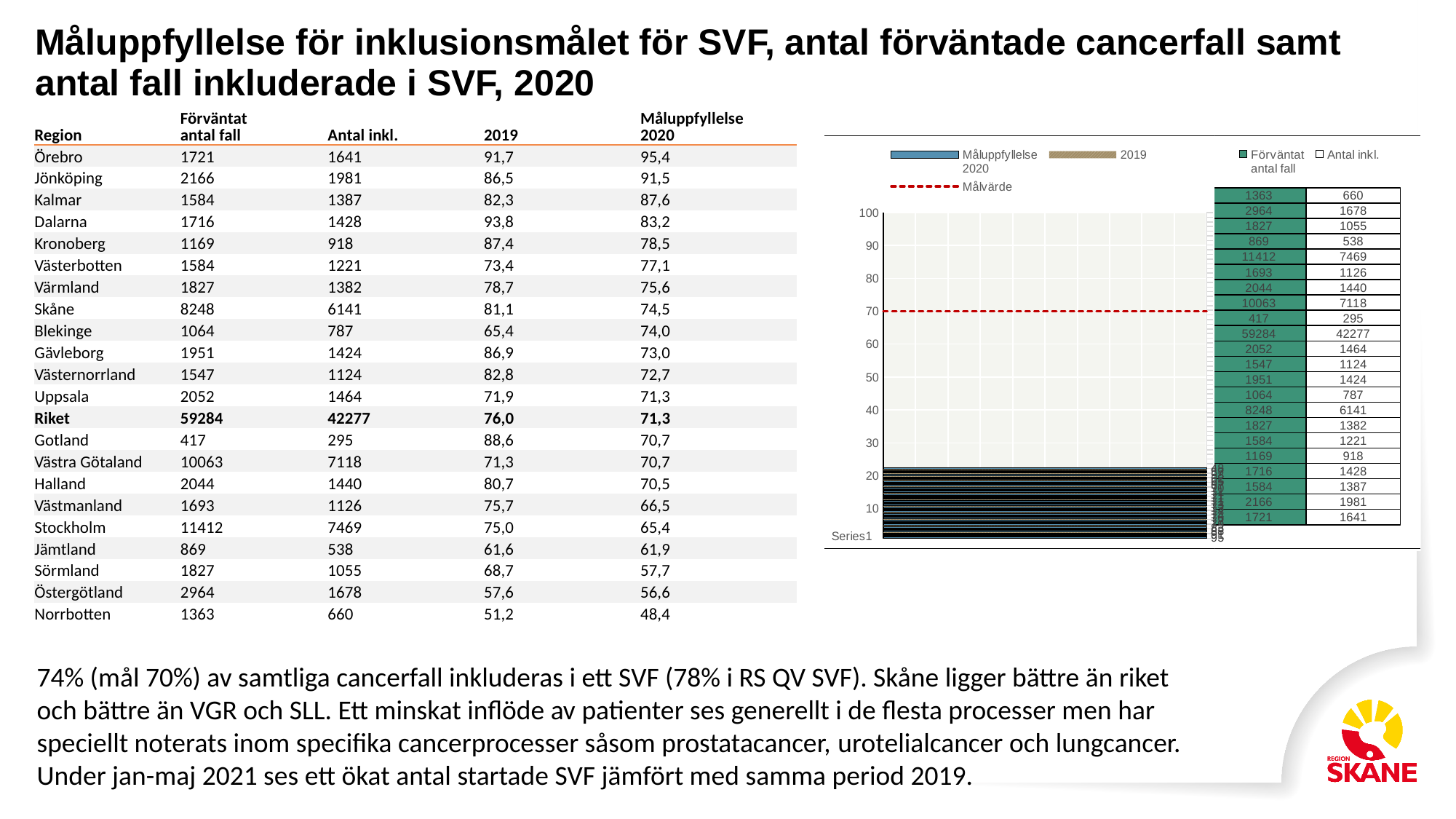
What is the highest tick shown on the chart's y axis? 100 What colour is the Förväntat antal fall column in the chart's data table? green What is the smallest value in the Antal inkl. column of the chart's data table? 295 What is the largest value in the Antal inkl. column of the chart's data table? 42277 How many entries does the legend of the chart list? 5 What is the smallest value in the Förväntat antal fall column of the chart's data table? 417 How many rows of values does the data table attached to the chart contain? 22 What kind of chart is shown on the right of the slide? bar chart What is the largest value in the Förväntat antal fall column of the chart's data table? 59284 How is the Målvärde series drawn in the chart? red dashed line At what value on the y axis does the dashed Målvärde line in the chart sit? 70